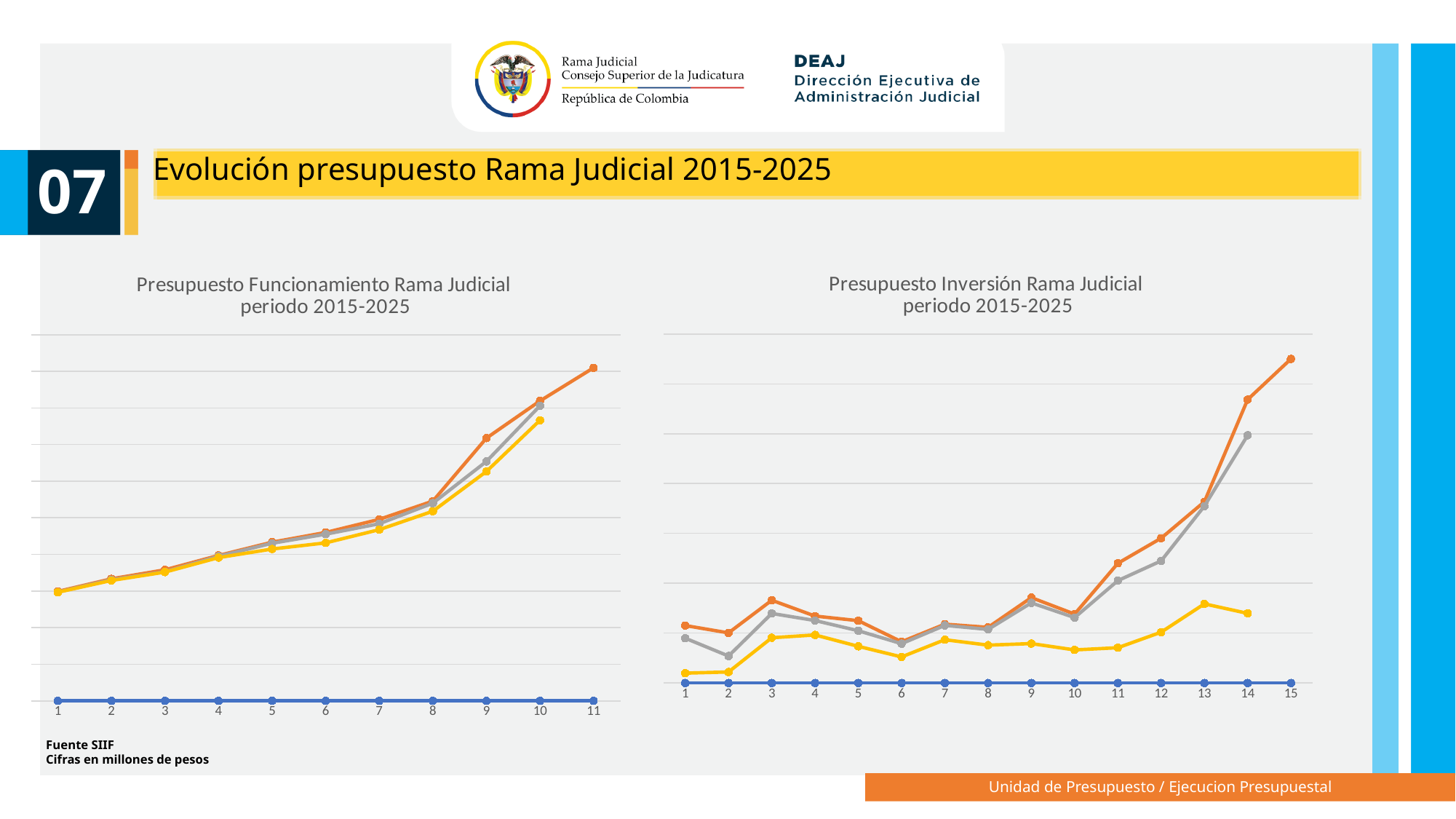
What kind of chart is the 'Presupuesto Funcionamiento Rama Judicial periodo 2015-2025' chart? Line chart How many points are labelled on the x axis of the 'Presupuesto Inversión Rama Judicial' chart? 15 What is the title of the chart on the left side of the slide? Presupuesto Funcionamiento Rama Judicial periodo 2015-2025 How many points are labelled on the x axis of the 'Presupuesto Funcionamiento Rama Judicial' chart? 11 In the 'Presupuesto Funcionamiento Rama Judicial' chart, at which x-axis point does the orange line reach its highest value? 11 In the 'Presupuesto Inversión Rama Judicial' chart, at point 13, which line is higher: the orange line or the yellow line? Orange line In the 'Presupuesto Inversión Rama Judicial' chart, at which x-axis point does the orange line reach its highest value? 15 In the 'Presupuesto Funcionamiento Rama Judicial' chart, does the orange line rise or fall from point 1 to point 11? Rise How many lines are plotted in the 'Presupuesto Inversión Rama Judicial' chart? 4 In the 'Presupuesto Funcionamiento Rama Judicial' chart, at point 10, which line is higher: the orange line or the yellow line? Orange line In the 'Presupuesto Inversión Rama Judicial' chart, does the orange line rise or fall from point 10 to point 15? Rise What kind of chart is the 'Presupuesto Inversión Rama Judicial periodo 2015-2025' chart? Line chart